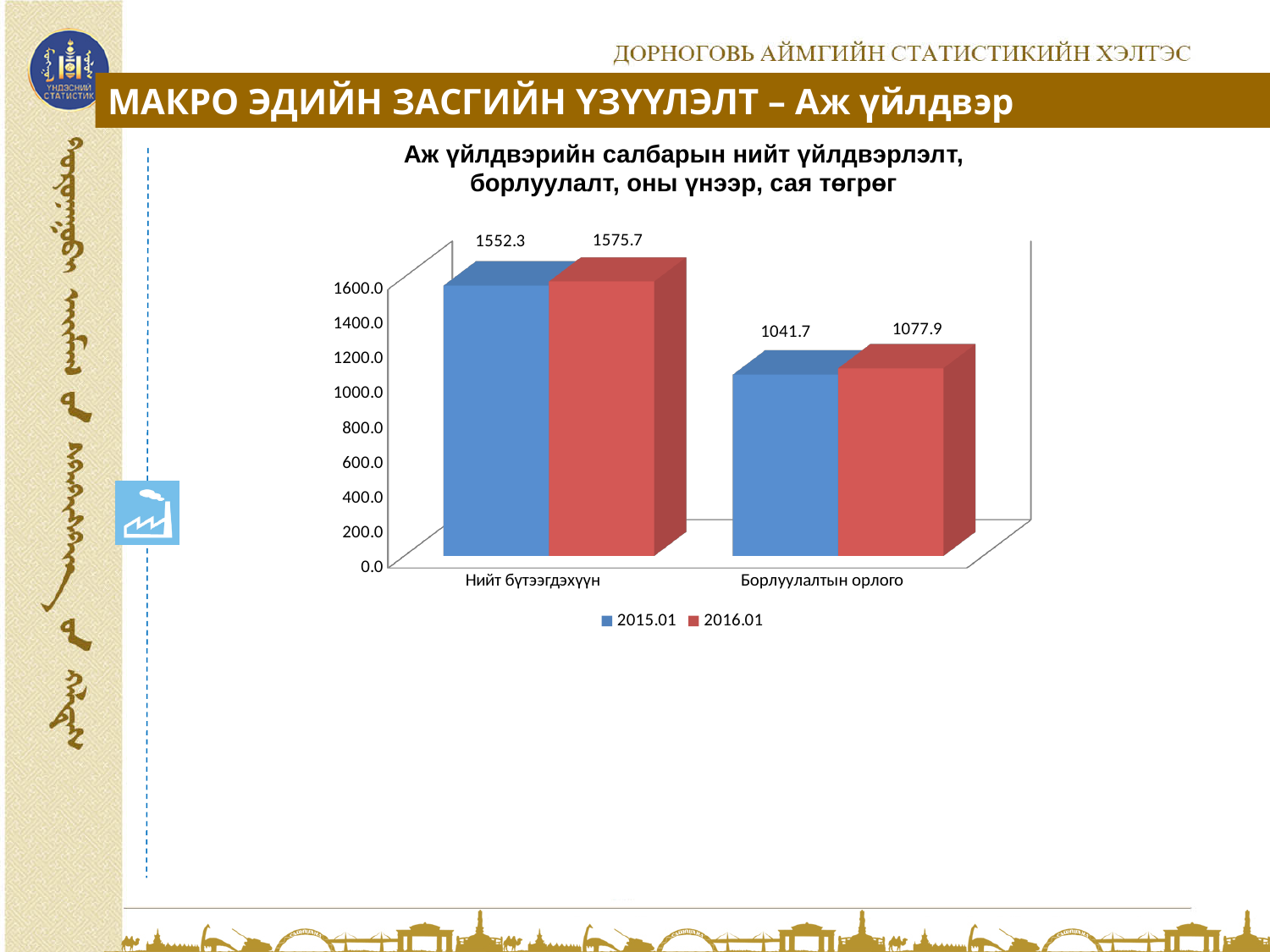
What is the value for Нийт бүтээгдэхүүн in the 2016.01 series? 1575.7 What is the value for Борлуулалтын орлого in the 2015.01 series? 1041.7 Which is larger for Борлуулалтын орлого: the 2015.01 value or the 2016.01 value? 2016.01 Which category has the highest value in the 2016.01 series? Нийт бүтээгдэхүүн What is the difference between the 2016.01 and 2015.01 values for Нийт бүтээгдэхүүн? 23.4 How many series does the legend list? 2 What is the value for Нийт бүтээгдэхүүн in the 2015.01 series? 1552.3 How many categories are shown on the x axis? 2 Which category has the lowest value in the 2015.01 series? Борлуулалтын орлого What is the value for Борлуулалтын орлого in the 2016.01 series? 1077.9 What kind of chart is shown on the slide? Bar chart What is the difference between the 2016.01 and 2015.01 values for Борлуулалтын орлого? 36.2